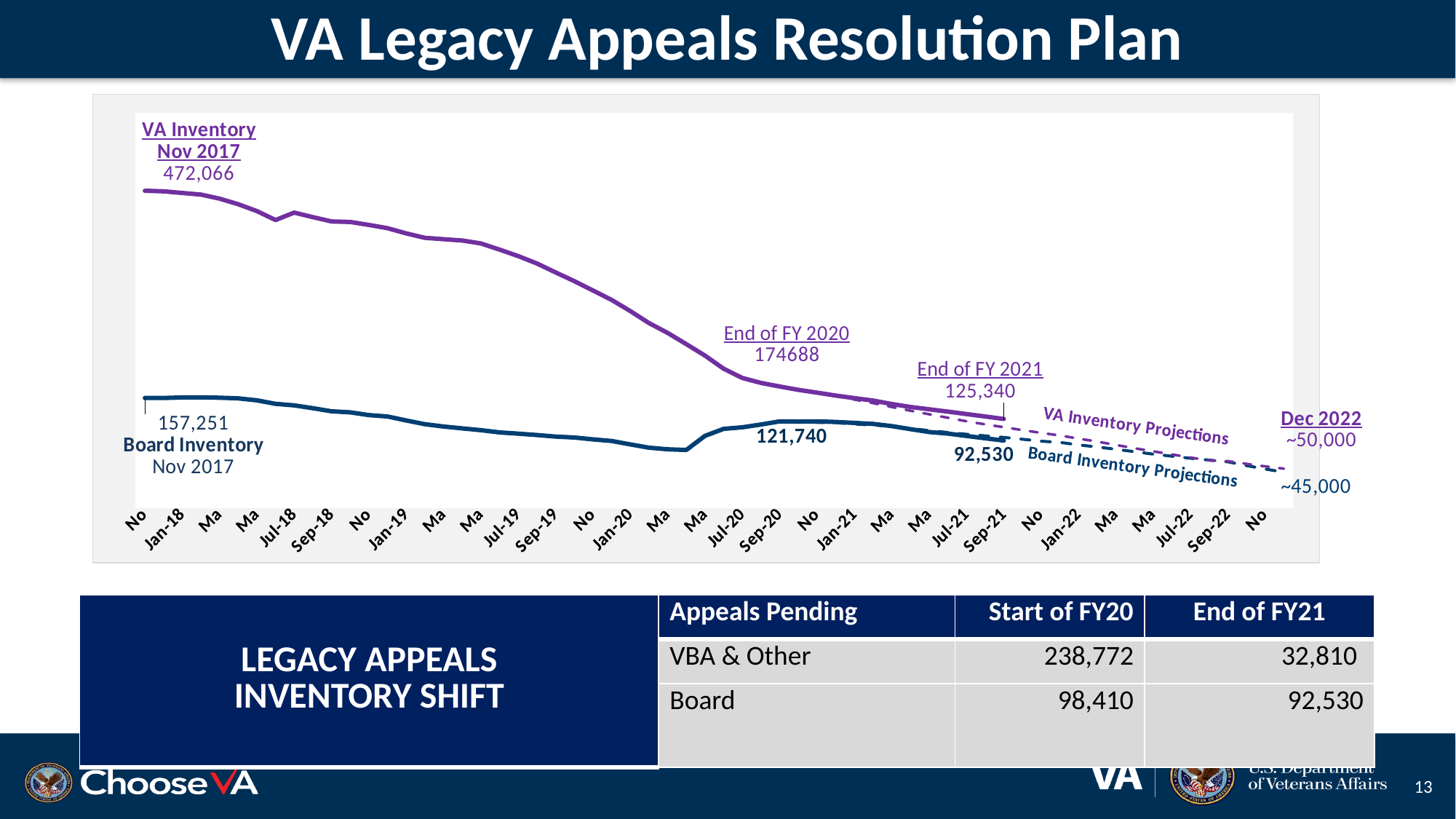
By how much did the VA Inventory fall from Nov 2017 (472,066) to the End of FY 2021 (125,340)? 346,726 What was the VA Inventory in Nov 2017 according to the chart? 472,066 What VA Inventory value is labelled at the End of FY 2020? 174688 What was the Board Inventory in Nov 2017 according to the chart? 157,251 What Board Inventory value is labelled at Sep-21 on the chart? 92,530 What is the difference between the VA Inventory at the End of FY 2020 and at the End of FY 2021? 49,348 What kind of chart is shown on the slide? Line chart Does the VA Inventory line rise or fall from Nov 2017 to Sep-21? Fall In Nov 2017, which was larger: the VA Inventory or the Board Inventory? VA Inventory What VA Inventory value is labelled at the End of FY 2021? 125,340 What do the dashed portions of the lines on the chart represent? Projections What Board Inventory value is labelled near Sep-20 on the chart? 121,740